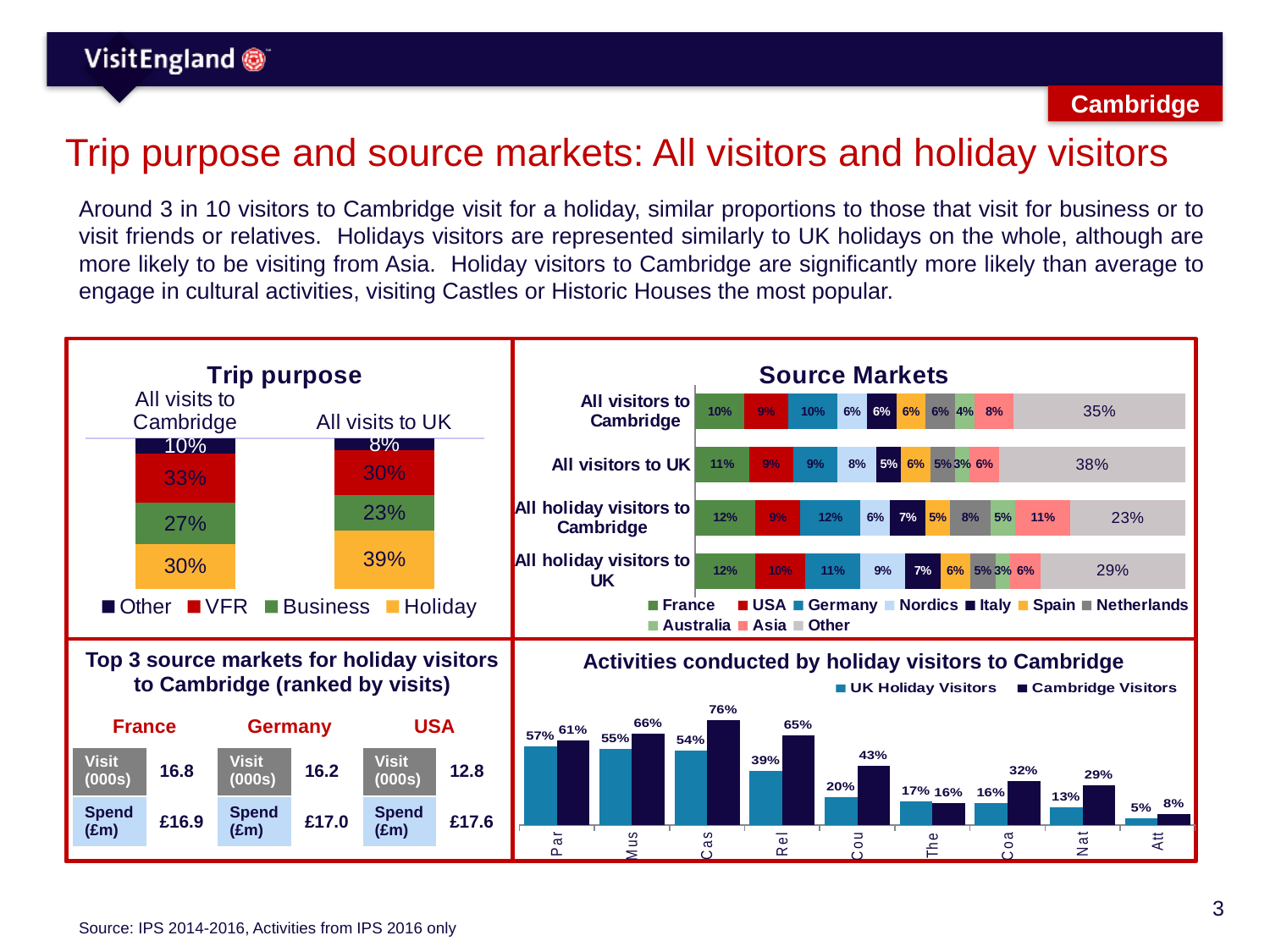
In the Source Markets chart, what percentage of all holiday visitors to Cambridge come from Asia? 11% In the Activities conducted by holiday visitors to Cambridge chart, what is the value for Cambridge Visitors in the category labelled 'Cas'? 76% In the Source Markets chart, which bar has the largest 'Other' share? All visitors to UK How many series does the legend of the Source Markets chart list? 10 In the Source Markets chart, what is the 'Other' share for all visitors to UK? 38% In the Trip purpose chart, what percentage of all visits to UK are VFR? 30% What kind of chart is the Activities conducted by holiday visitors to Cambridge chart? Bar chart How many series does the legend of the Trip purpose chart list? 4 In the Activities conducted by holiday visitors to Cambridge chart, which category has the lowest value for UK Holiday Visitors? Att In the Trip purpose chart, what is the difference between the Holiday share for all visits to UK and for all visits to Cambridge? 9 percentage points In the Trip purpose chart, what percentage of all visits to Cambridge are for Holiday? 30% In the Activities conducted by holiday visitors to Cambridge chart, which is larger in the category labelled 'The': UK Holiday Visitors or Cambridge Visitors? UK Holiday Visitors